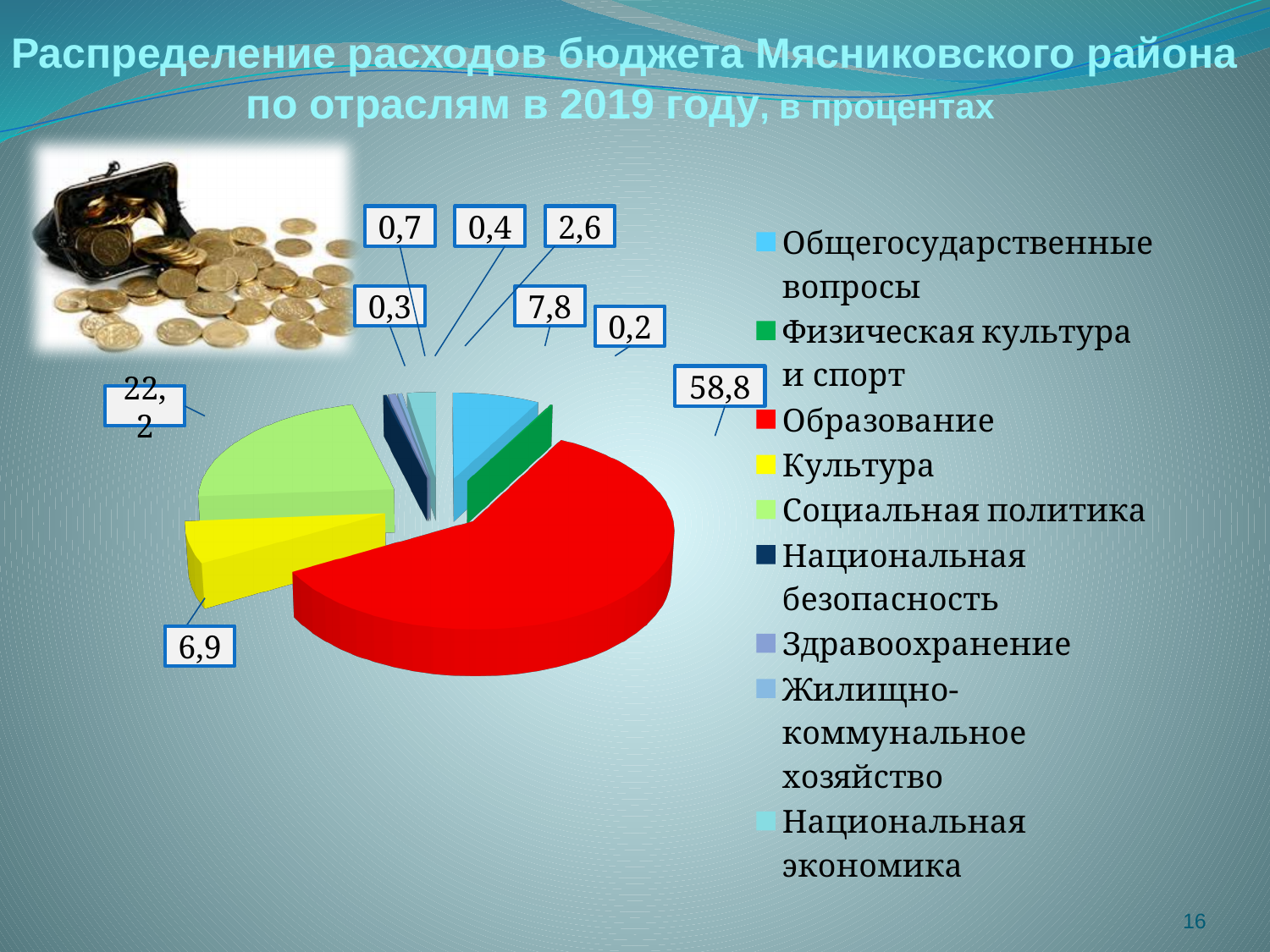
What is the value shown for Физическая культура и спорт? 0,2 What colour is the slice for Образование in the pie chart? red Which is larger, the value for Культура or the value for Общегосударственные вопросы? Общегосударственные вопросы What kind of chart is shown on the slide? pie chart How many categories does the legend of the pie chart list? 9 What is the value shown for Культура? 6,9 Which category has the largest share of the pie chart? Образование What is the smallest data label value shown on the pie chart? 0,2 What is the value shown for Социальная политика? 22,2 What is the value shown for Образование? 58,8 What is the value shown for Общегосударственные вопросы? 7,8 What is the difference between the values for Образование and Социальная политика? 36,6